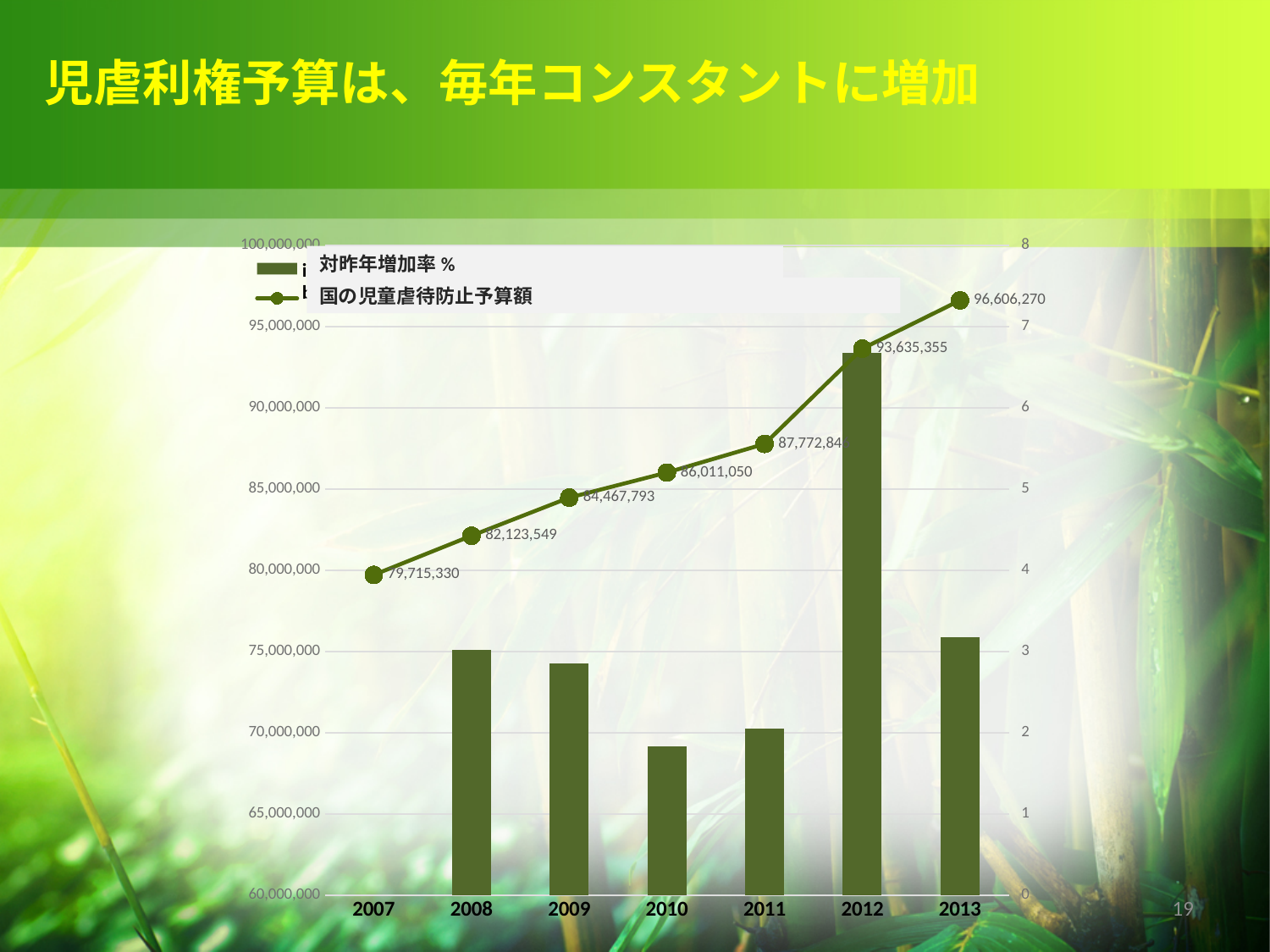
By how much did 国の児童虐待防止予算額 increase from 2007 to 2008? 2,408,219 Is the 対昨年増加率 % value for 2010 greater or less than 2? less What is the value of 国の児童虐待防止予算額 for 2013? 96,606,270 What is the value of 国の児童虐待防止予算額 for 2012? 93,635,355 Does 国の児童虐待防止予算額 rise or fall from 2007 to 2013? rise In which year is 国の児童虐待防止予算額 lowest? 2007 In which year is 国の児童虐待防止予算額 highest? 2013 How many series does the legend list? 2 What is the value of 国の児童虐待防止予算額 for 2007? 79,715,330 Is the 対昨年増加率 % value for 2012 greater or less than 6? greater By how much did 国の児童虐待防止予算額 increase from 2012 to 2013? 2,970,915 In which year is the 対昨年増加率 % bar the tallest? 2012